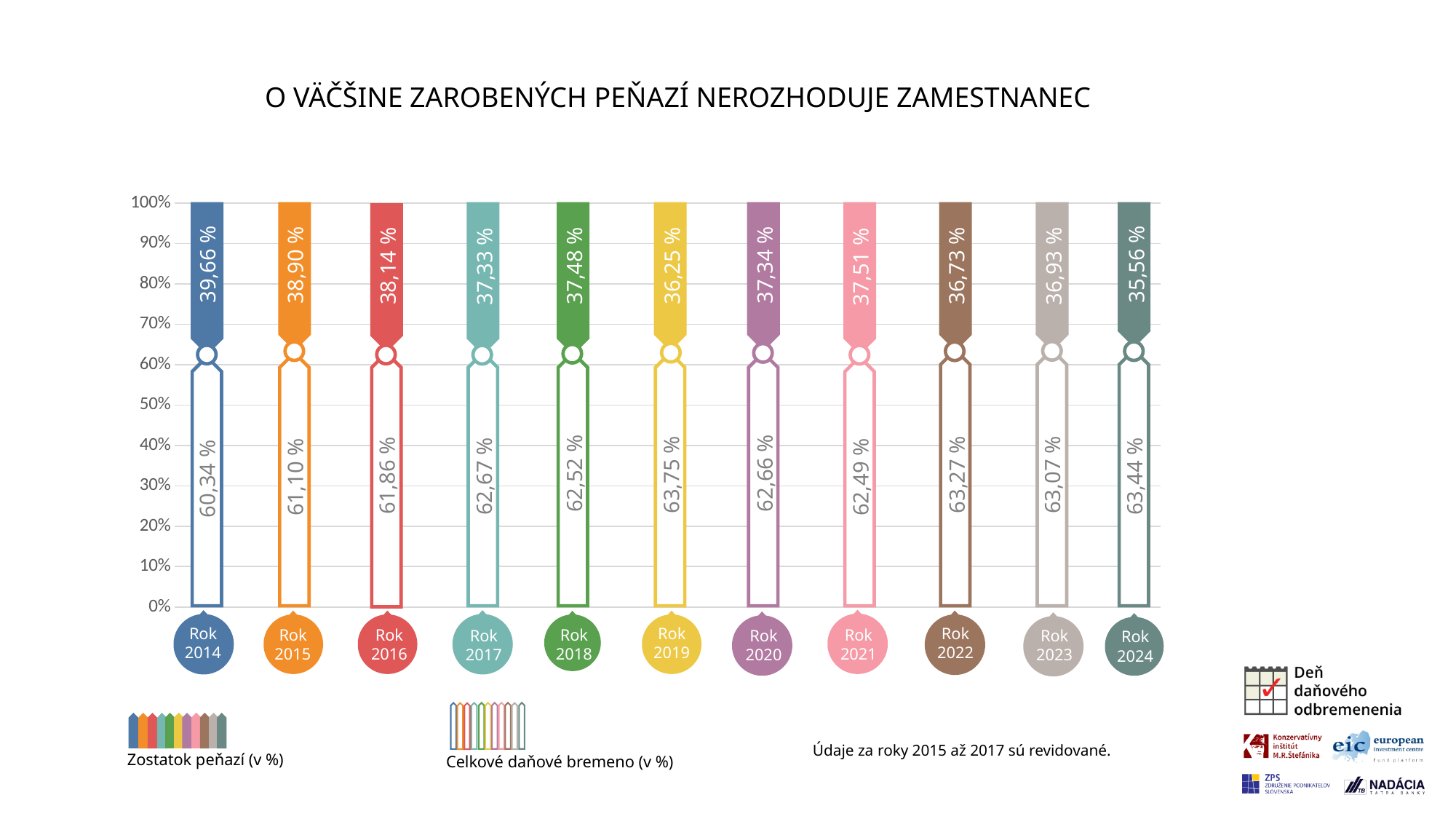
Which is larger: 'Celkové daňové bremeno (v %)' for Rok 2016 or for Rok 2022? Rok 2022 What is the difference between the 'Zostatok peňazí (v %)' values for Rok 2014 and Rok 2019? 3,41 % How many series does the legend list? 2 Which year has the highest value of 'Zostatok peňazí (v %)'? Rok 2014 What is the value of 'Zostatok peňazí (v %)' for Rok 2014? 39,66 % How many years (categories) are shown on the x axis of the chart? 11 Does the value of 'Zostatok peňazí (v %)' generally rise or fall from Rok 2014 to Rok 2024? fall Which year has the lowest value of 'Celkové daňové bremeno (v %)'? Rok 2014 What type of chart is shown on the slide? stacked bar chart What is the value of 'Zostatok peňazí (v %)' for Rok 2021? 37,51 % What is the value of 'Celkové daňové bremeno (v %)' for Rok 2019? 63,75 % What is the title of the chart? O VÄČŠINE ZAROBENÝCH PEŇAZÍ NEROZHODUJE ZAMESTNANEC